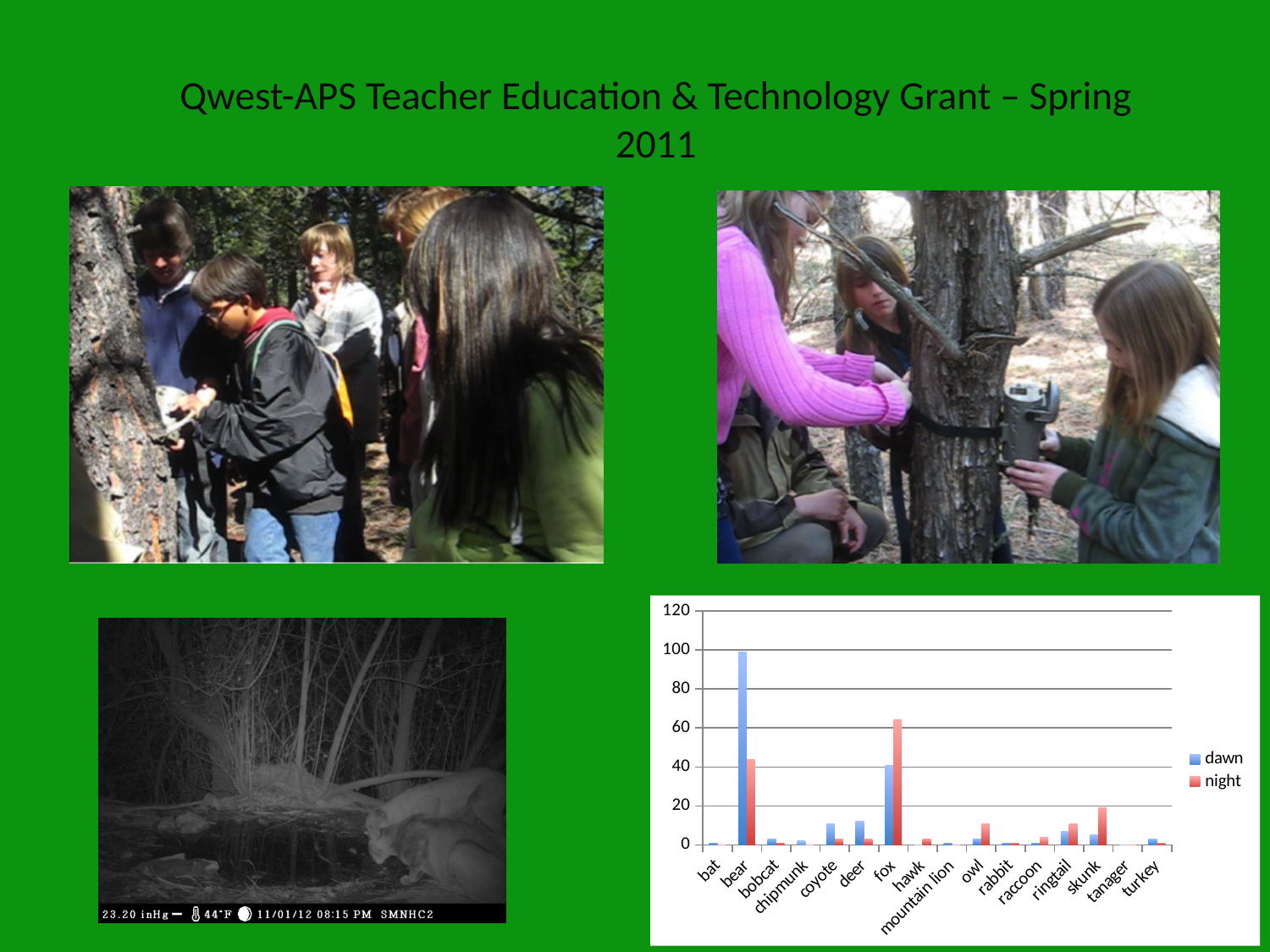
Which animal has the highest night value in the chart? fox What kind of chart is shown on the slide? bar chart How many series does the chart's legend list? 2 Is the night value for skunk greater or less than 40? less Is the dawn value for bear greater or less than 80? greater What is the highest value shown on the chart's y axis? 120 Is the night value for fox greater or less than 40? greater How many animal categories are shown on the x axis of the chart? 16 For bear, which is larger: the dawn value or the night value? dawn Which series is shown in red in the chart? night Which animal has the highest dawn value in the chart? bear For fox, which is larger: the dawn value or the night value? night